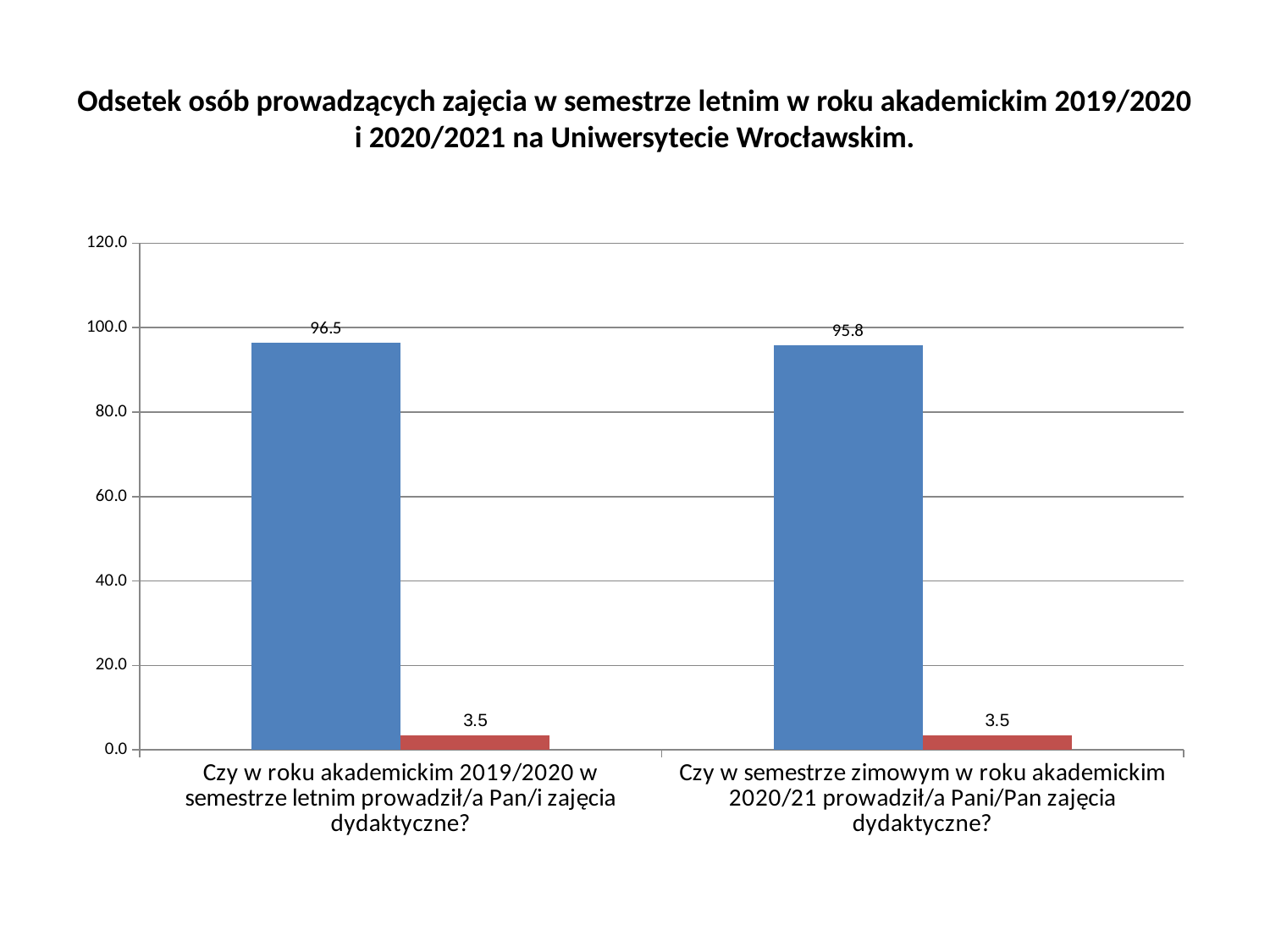
Is the blue bar for the 2019/2020 summer semester category greater or less than 80.0? greater What is the value of the blue bar for the category "Czy w semestrze zimowym w roku akademickim 2020/21 prowadził/a Pani/Pan zajęcia dydaktyczne?"? 95.8 What is the value of the red bar for the category about the summer semester of 2019/2020? 3.5 What is the difference between the blue and red bar values for the category about the summer semester of 2019/2020? 93.0 What is the value of the blue bar for the category "Czy w roku akademickim 2019/2020 w semestrze letnim prowadził/a Pan/i zajęcia dydaktyczne?"? 96.5 What is the highest value shown on the vertical axis? 120.0 What is the value of the red bar for the category about the winter semester of 2020/21? 3.5 What is the difference between the blue bar values of the two categories? 0.7 What kind of chart is shown on the slide? Bar chart Which category has the higher blue bar? Czy w roku akademickim 2019/2020 w semestrze letnim prowadził/a Pan/i zajęcia dydaktyczne? How many categories are shown on the x axis? 2 Is the red bar for the 2020/21 winter semester category greater or less than 20.0? less